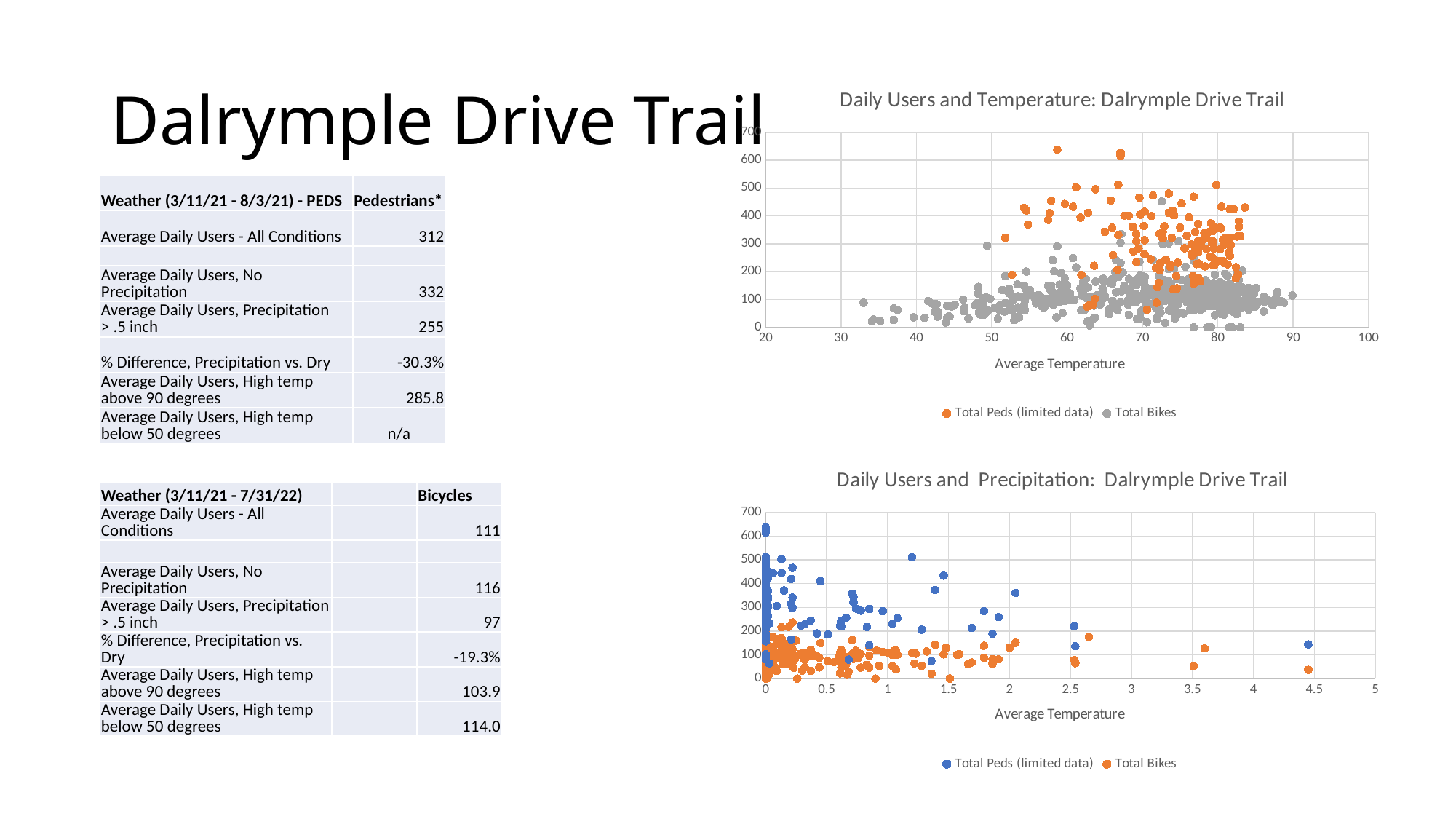
How many series does the legend of the 'Daily Users and Precipitation: Dalrymple Drive Trail' chart list? 2 In the 'Daily Users and Precipitation: Dalrymple Drive Trail' chart, which series is shown in blue? Total Peds (limited data) How many series does the legend of the 'Daily Users and Temperature: Dalrymple Drive Trail' chart list? 2 What kind of chart is the 'Daily Users and Precipitation: Dalrymple Drive Trail' chart? Scatter chart In the 'Daily Users and Precipitation: Dalrymple Drive Trail' chart, which series reaches the higher daily user values, Total Peds (limited data) or Total Bikes? Total Peds (limited data) In the 'Daily Users and Temperature: Dalrymple Drive Trail' chart, which series is shown in grey? Total Bikes In the 'Daily Users and Temperature: Dalrymple Drive Trail' chart, is the lowest temperature shown on the x axis greater or less than 30? less In the 'Daily Users and Temperature: Dalrymple Drive Trail' chart, which series reaches the higher daily user values, Total Peds (limited data) or Total Bikes? Total Peds (limited data) What kind of chart is the 'Daily Users and Temperature: Dalrymple Drive Trail' chart? Scatter chart In the 'Daily Users and Temperature: Dalrymple Drive Trail' chart, is the highest Total Peds (limited data) point greater or less than 600? greater